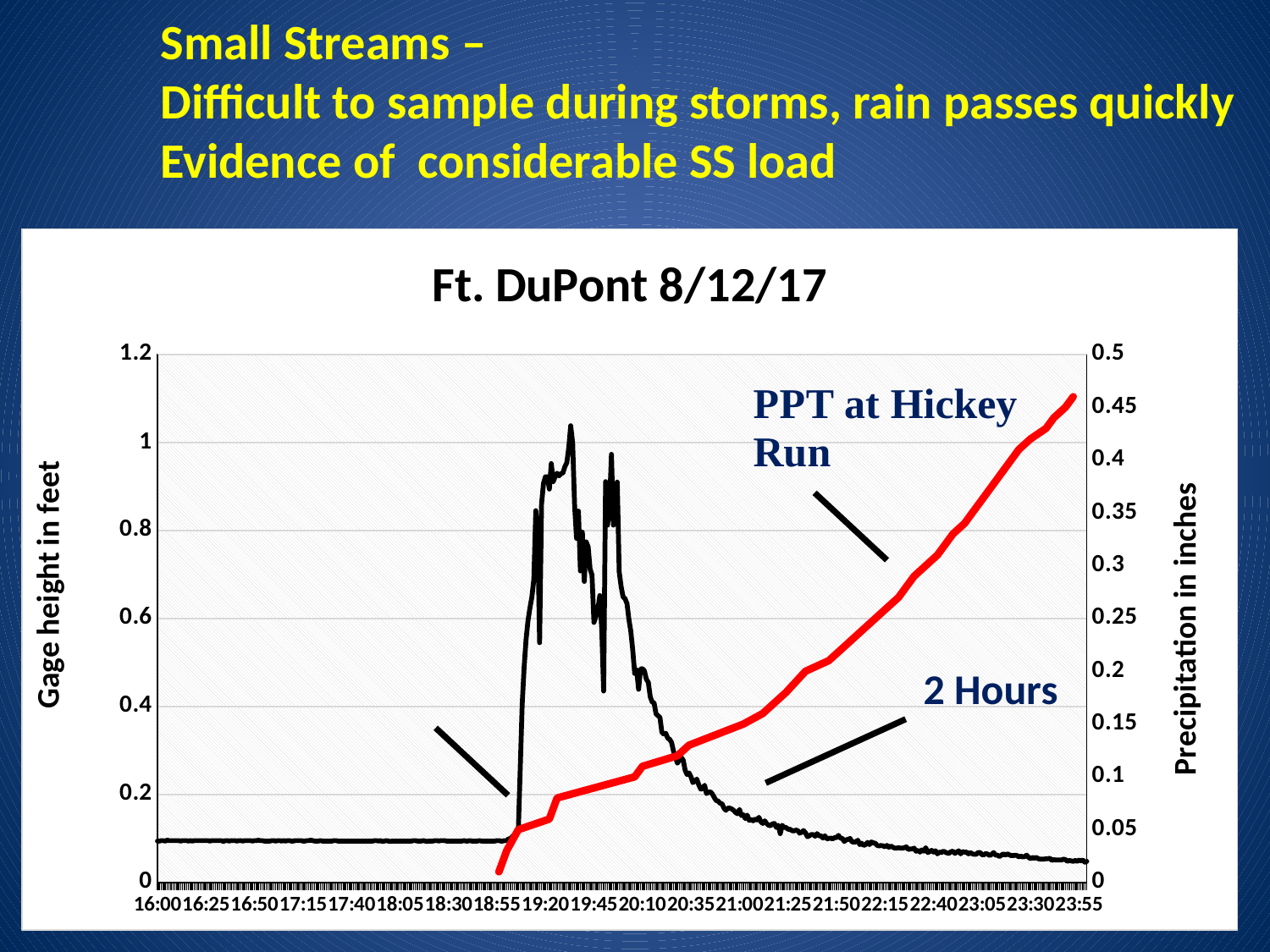
Is the gage height at 23:55 greater or less than 0.2 feet? less What kind of chart is shown on the slide? line chart What is the title of the chart? Ft. DuPont 8/12/17 What is the highest tick value shown on the right vertical axis? 0.5 Does the gage height rise or fall from 20:10 to 23:55? fall Does the precipitation line rise or fall from 19:00 to 23:55? rise Is the precipitation at 23:55 greater or less than 0.4 inches? greater How many lines are plotted on the chart? 2 Is the gage height at 16:00 greater or less than 0.2 feet? less What is the label of the left vertical axis? Gage height in feet